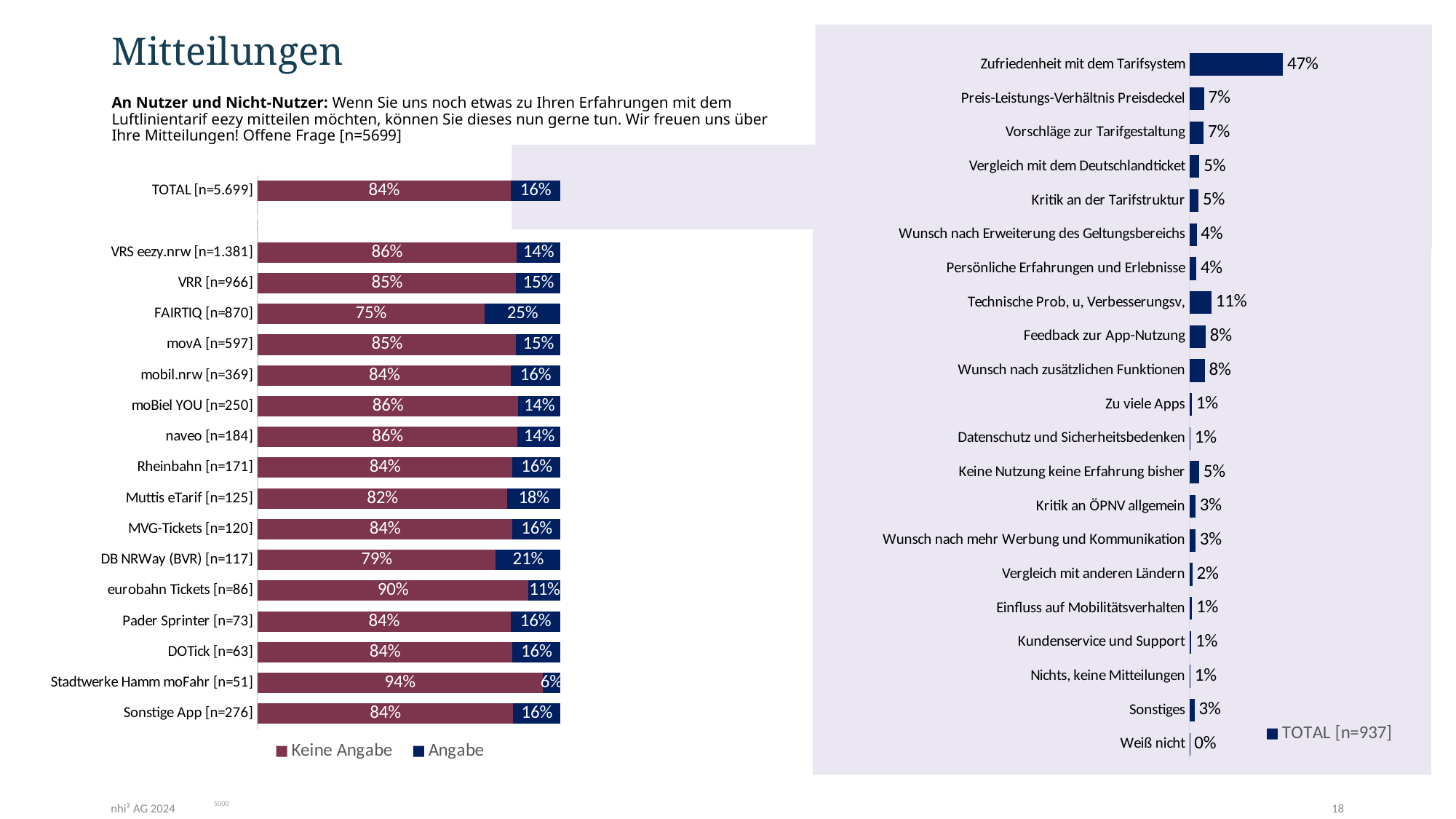
In the right chart, which is larger: 'Feedback zur App-Nutzung' or 'Kritik an ÖPNV allgemein'? Feedback zur App-Nutzung In the left chart, which category has the highest 'Angabe' share? FAIRTIQ [n=870] In the left chart, what is the difference between the 'Angabe' shares of DB NRWay (BVR) [n=117] and eurobahn Tickets [n=86]? 10% In the left chart, how many categories are shown? 17 In the left chart, which category has the lowest 'Angabe' share? Stadtwerke Hamm moFahr [n=51] In the left chart, how many series does the legend list? 2 In the right chart, which category has the lowest value? Weiß nicht In the right chart, what is the value for 'Technische Prob, u, Verbesserungsv,'? 11% In the left chart, what is the 'Keine Angabe' share for Stadtwerke Hamm moFahr [n=51]? 94% In the left chart, what is the 'Angabe' share for FAIRTIQ [n=870]? 25% In the right chart, what is the value for 'Zufriedenheit mit dem Tarifsystem'? 47% In the right chart, how many categories are shown? 21